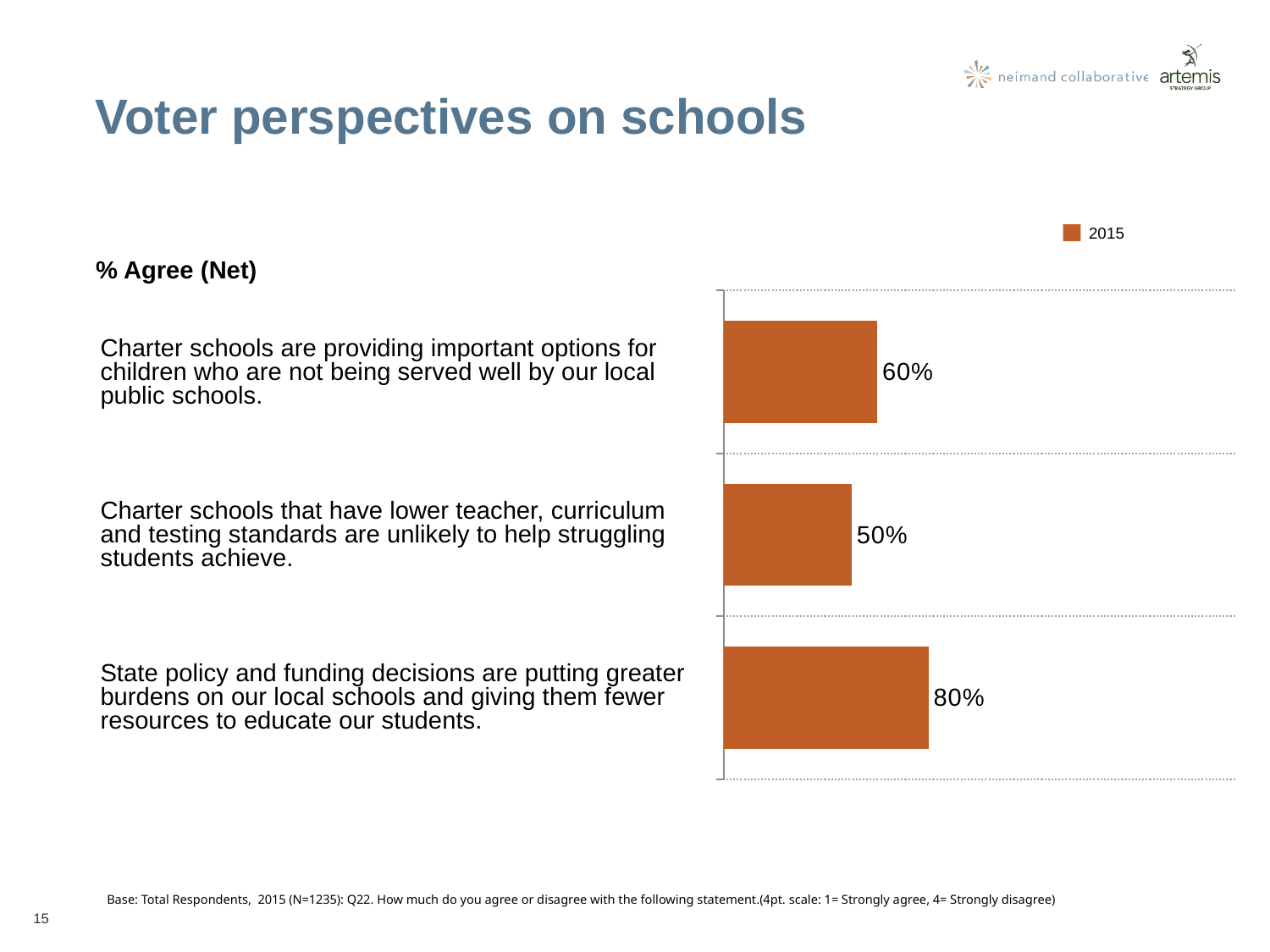
Which has a higher % Agree: the statement that charter schools provide important options, or the statement that charter schools with lower standards are unlikely to help struggling students? Charter schools are providing important options for children who are not being served well by our local public schools. What percentage of voters agree that state policy and funding decisions are putting greater burdens on local schools? 80% What percentage of voters agree that charter schools are providing important options for children who are not being served well by local public schools? 60% Which statement has the lowest % Agree (Net)? Charter schools that have lower teacher, curriculum and testing standards are unlikely to help struggling students achieve. What percentage of voters agree that charter schools with lower teacher, curriculum and testing standards are unlikely to help struggling students achieve? 50% What year does the legend entry refer to? 2015 How many statements are shown in the chart? 3 What kind of chart is shown on the slide? Bar chart What is the difference in % Agree between the state policy and funding statement and the charter schools providing important options statement? 20% Which statement has the highest % Agree (Net)? State policy and funding decisions are putting greater burdens on our local schools and giving them fewer resources to educate our students. What is the difference in % Agree between the two charter school statements? 10% How many series does the legend list? 1